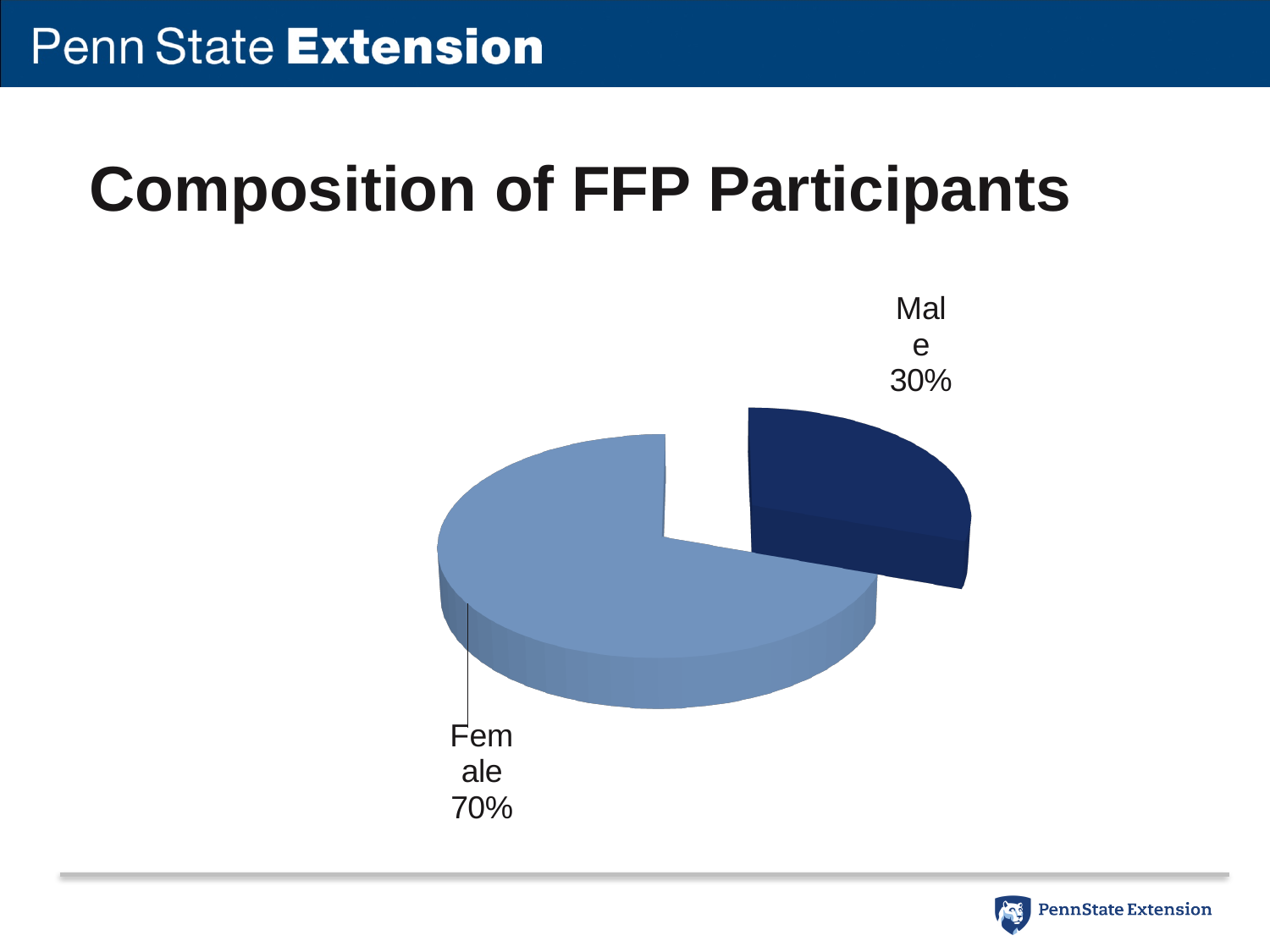
What share of FFP participants is Male? 30% Which is larger, the Female share or the Male share? Female How many slices does the pie chart have? 2 What share of FFP participants is Female? 70% Which category has the largest share of the pie? Female What is the title of the slide containing the chart? Composition of FFP Participants What kind of chart is shown on the slide? pie chart Is the Male share greater or less than 50%? less Which slice is shown in the darker blue colour? Male What is the difference in percentage points between the Female and Male shares? 40 Which category has the smallest share of the pie? Male